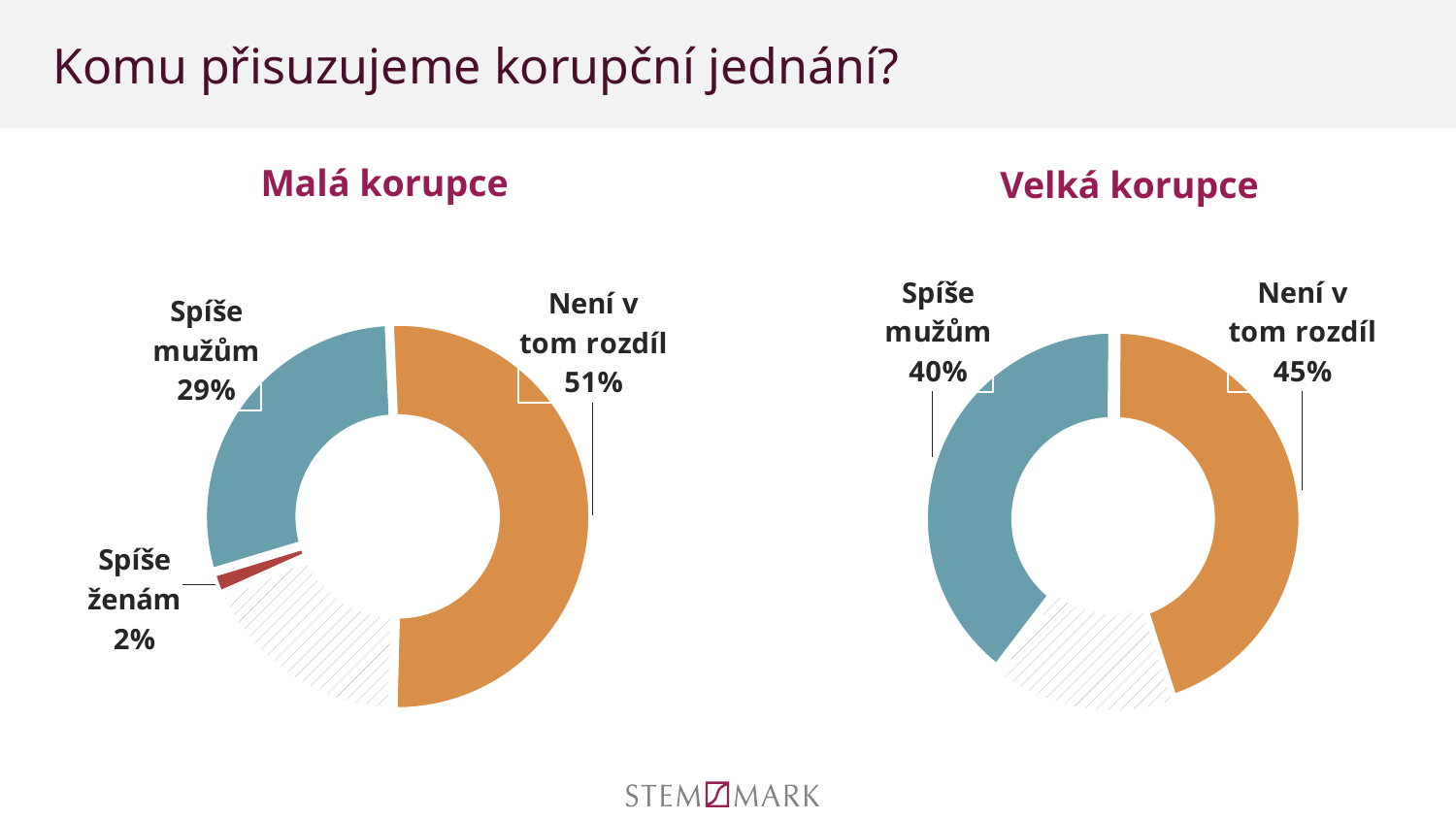
In the 'Velká korupce' chart, what is the difference in percentage points between 'Není v tom rozdíl' and 'Spíše mužům'? 5 Which chart shows a larger share for 'Spíše mužům', 'Malá korupce' or 'Velká korupce'? Velká korupce In the 'Velká korupce' chart, what share is labelled 'Není v tom rozdíl'? 45% What kind of chart is used for 'Malá korupce'? Pie (donut) chart In the 'Malá korupce' chart, what share is labelled 'Spíše mužům'? 29% What is the title of the slide? Komu přisuzujeme korupční jednání? In the 'Malá korupce' chart, which labelled category has the smallest share? Spíše ženám In the 'Malá korupce' chart, what share is labelled 'Není v tom rozdíl'? 51% In the 'Malá korupce' chart, what is the difference in percentage points between 'Není v tom rozdíl' and 'Spíše mužům'? 22 In the 'Malá korupce' chart, which labelled category has the largest share? Není v tom rozdíl In the 'Malá korupce' chart, what share is labelled 'Spíše ženám'? 2% In the 'Velká korupce' chart, what share is labelled 'Spíše mužům'? 40%